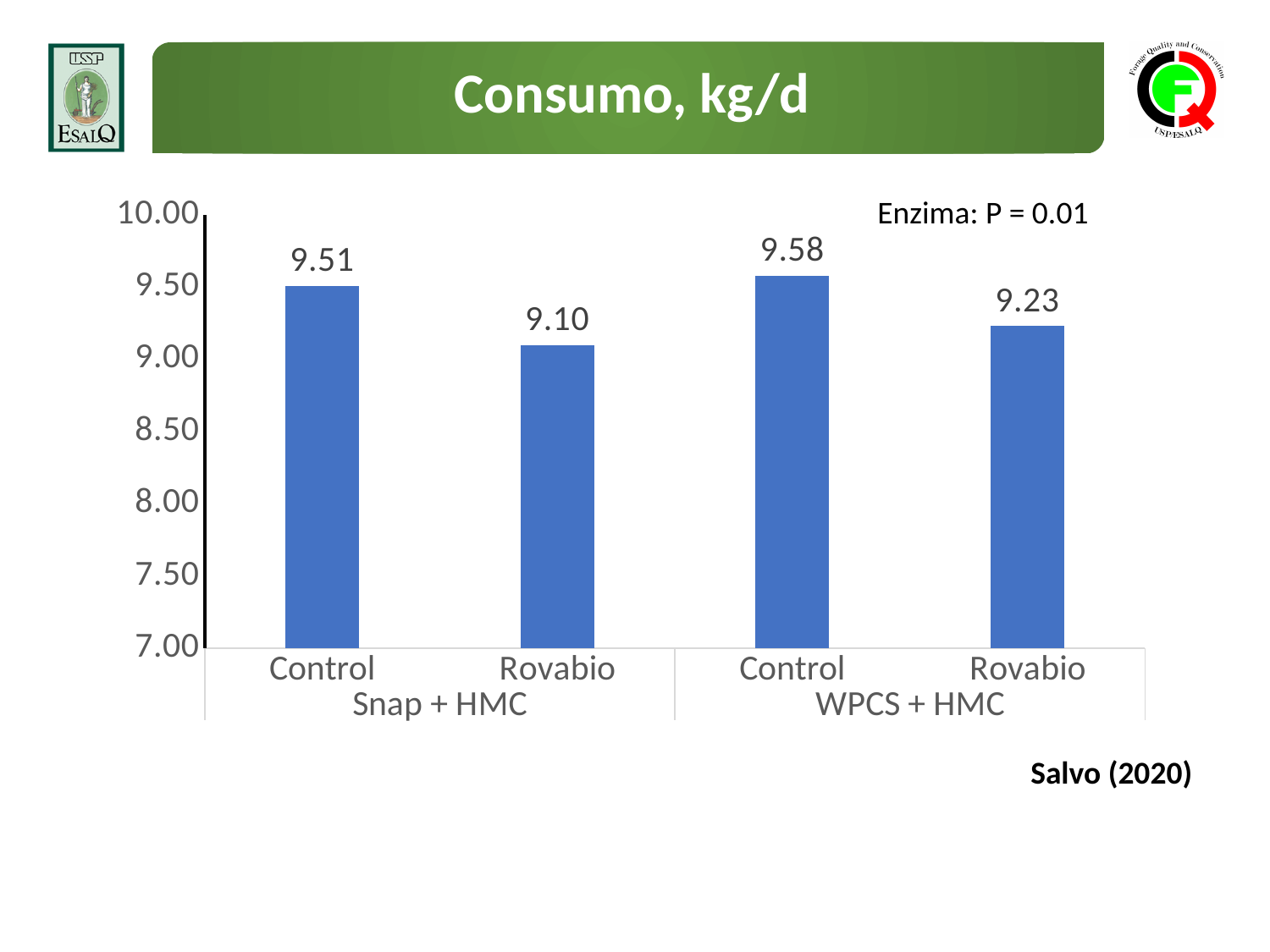
What kind of chart is shown on the slide? Bar chart What is the value for Control in the Snap + HMC group? 9.51 What is the title of the chart? Consumo, kg/d What is the value for Control in the WPCS + HMC group? 9.58 What is the difference between Control and Rovabio in the WPCS + HMC group? 0.35 How many bars are plotted in the chart? 4 What is the value for Rovabio in the Snap + HMC group? 9.10 What is the value for Rovabio in the WPCS + HMC group? 9.23 Which bar has the highest value? Control (WPCS + HMC) Which bar has the lowest value? Rovabio (Snap + HMC) What is the difference between Control and Rovabio in the Snap + HMC group? 0.41 Which is larger, Rovabio in Snap + HMC or Rovabio in WPCS + HMC? Rovabio in WPCS + HMC